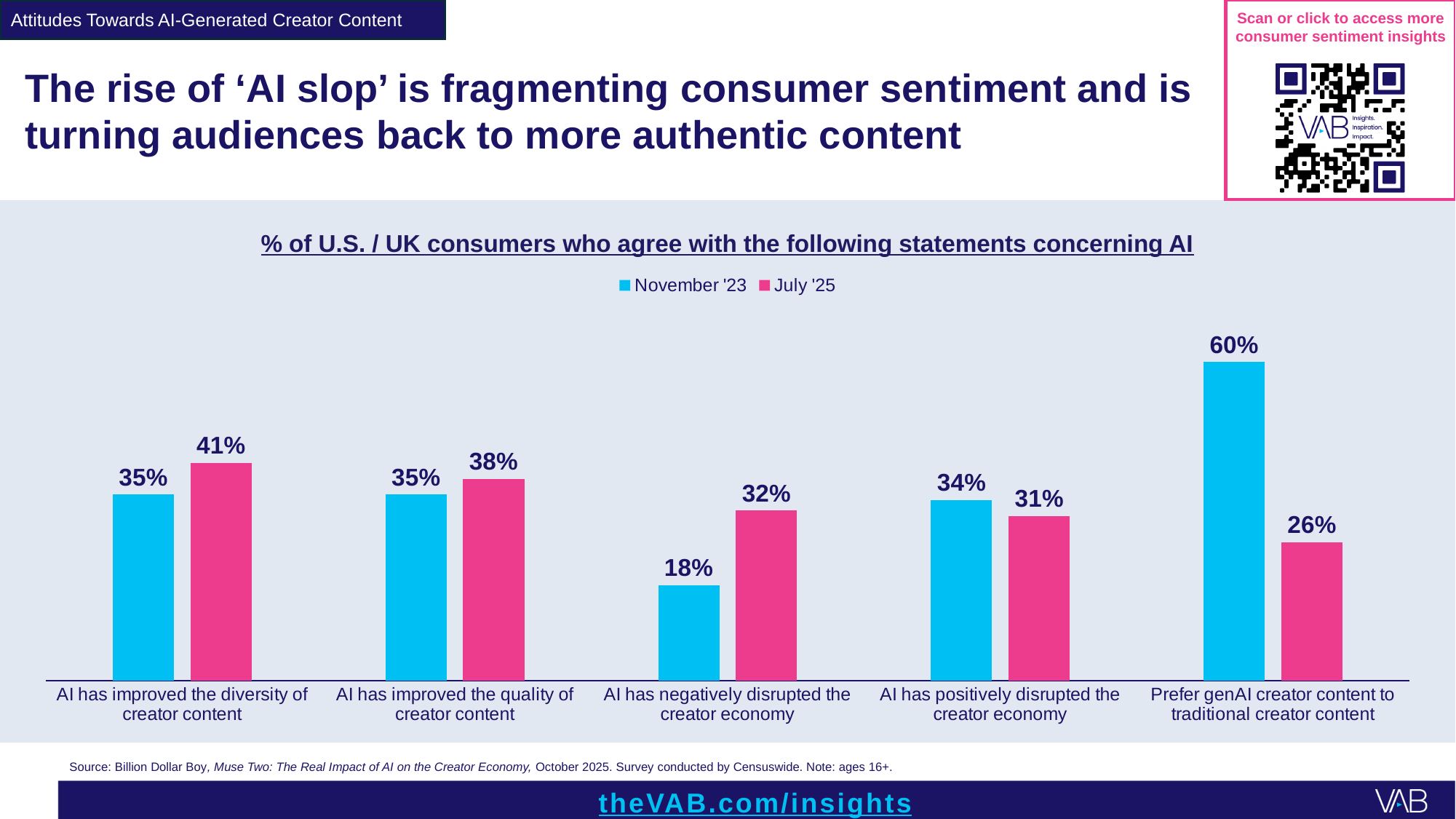
How many series does the legend list? 2 What percentage preferred genAI creator content to traditional creator content in July '25? 26% What was the November '23 value for 'AI has negatively disrupted the creator economy'? 18% Which colour represents the July '25 series in the chart? Pink Which statement had the highest November '23 value? Prefer genAI creator content to traditional creator content How many statements (categories) are shown on the x axis? 5 Which statement had the lowest July '25 value? Prefer genAI creator content to traditional creator content By how many percentage points did agreement with 'Prefer genAI creator content to traditional creator content' fall from November '23 to July '25? 34 percentage points What type of chart is shown on the slide? Bar chart What is the difference between the July '25 and November '23 values for 'AI has negatively disrupted the creator economy'? 14 percentage points What percentage of consumers agreed that AI has improved the diversity of creator content in July '25? 41% For 'AI has positively disrupted the creator economy', which is larger: the November '23 value or the July '25 value? November '23